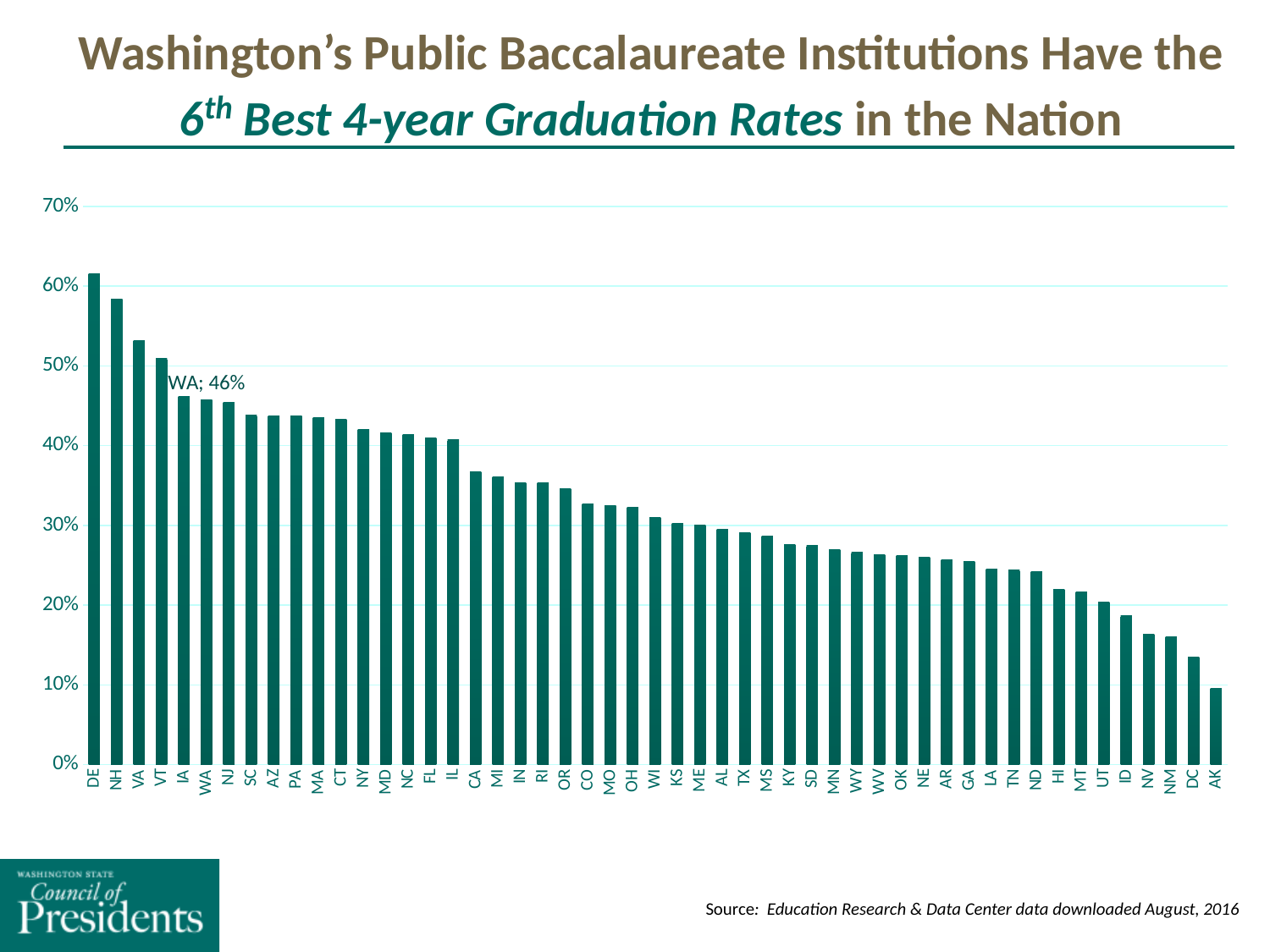
Is the value for NH greater or less than 60%? less Is the value for DC greater or less than 10%? greater Which has the higher graduation rate, DE or NH? DE What is the 4-year graduation rate shown for WA? 46% What kind of chart is shown on the slide? Bar chart How many states/jurisdictions are plotted on the chart? 51 Which bar on the chart has a data label printed next to it? WA Do the graduation rates rise or fall moving from left to right along the x axis? Fall Which state has the lowest 4-year graduation rate on the chart? AK Which state has the highest 4-year graduation rate on the chart? DE Is the value for CA greater or less than 30%? greater